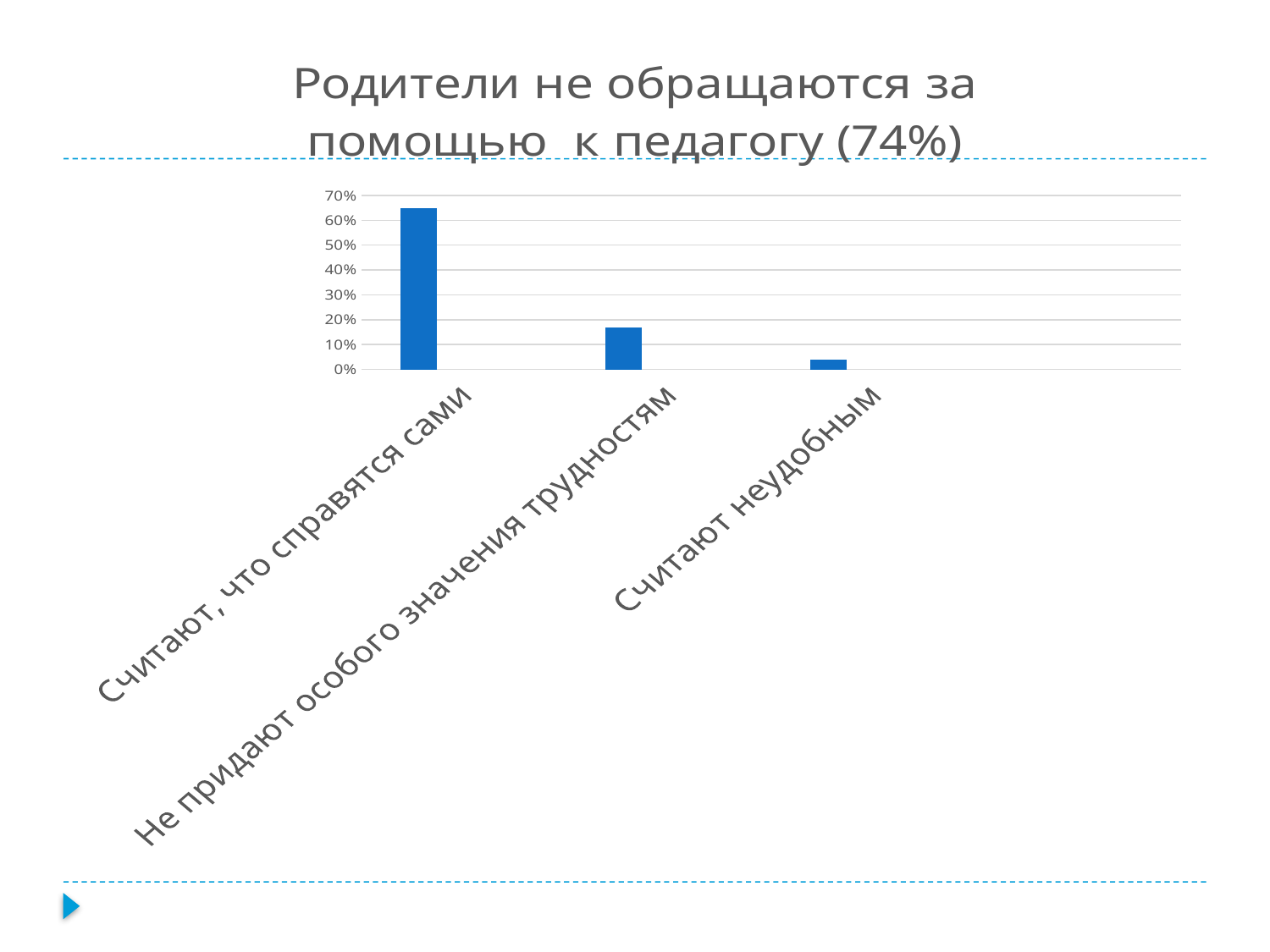
Do the bar values rise or fall from left to right along the x axis? fall Which is larger: the value for "Считают, что справятся сами" or the value for "Не придают особого значения трудностям"? Считают, что справятся сами Is the value for "Считают неудобным" greater or less than 10%? less Is the value for "Не придают особого значения трудностям" greater or less than 10%? greater Is the value for "Считают, что справятся сами" greater or less than 60%? greater How many categories are plotted in the chart? 3 Which category has the highest value? Считают, что справятся сами What is the highest value shown on the vertical axis? 70% What kind of chart is shown on the slide? bar chart Which category has the lowest value? Считают неудобным What is the title of the slide containing the chart? Родители не обращаются за помощью к педагогу (74%)